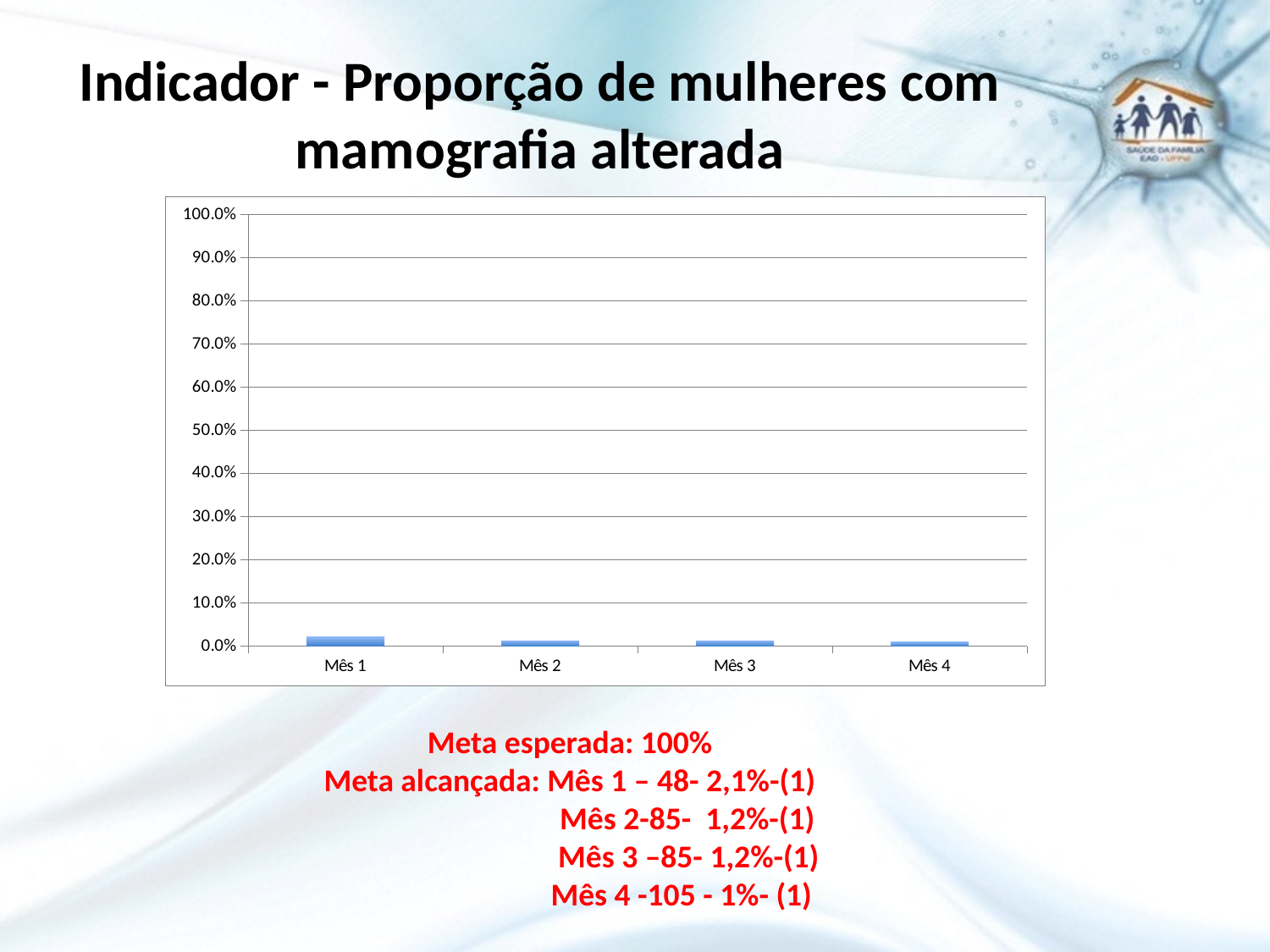
What is the highest value shown on the y axis of the chart? 100.0% How many categories are shown on the x axis of the chart? 4 Is the value for Mês 3 greater or less than 10%? less Is the value for Mês 1 greater or less than 10%? less What kind of chart is shown on the slide? bar chart Do the bar values generally rise or fall from Mês 1 to Mês 4? fall Is the value for Mês 4 greater or less than 20%? less According to the text below the chart, what proportion was reached in Mês 4? 1% Which is larger, the bar for Mês 1 or the bar for Mês 2? Mês 1 According to the text below the chart, what proportion was reached in Mês 1? 2,1% According to the text below the chart, what is the expected target (Meta esperada)? 100% Which month has the highest bar in the chart? Mês 1